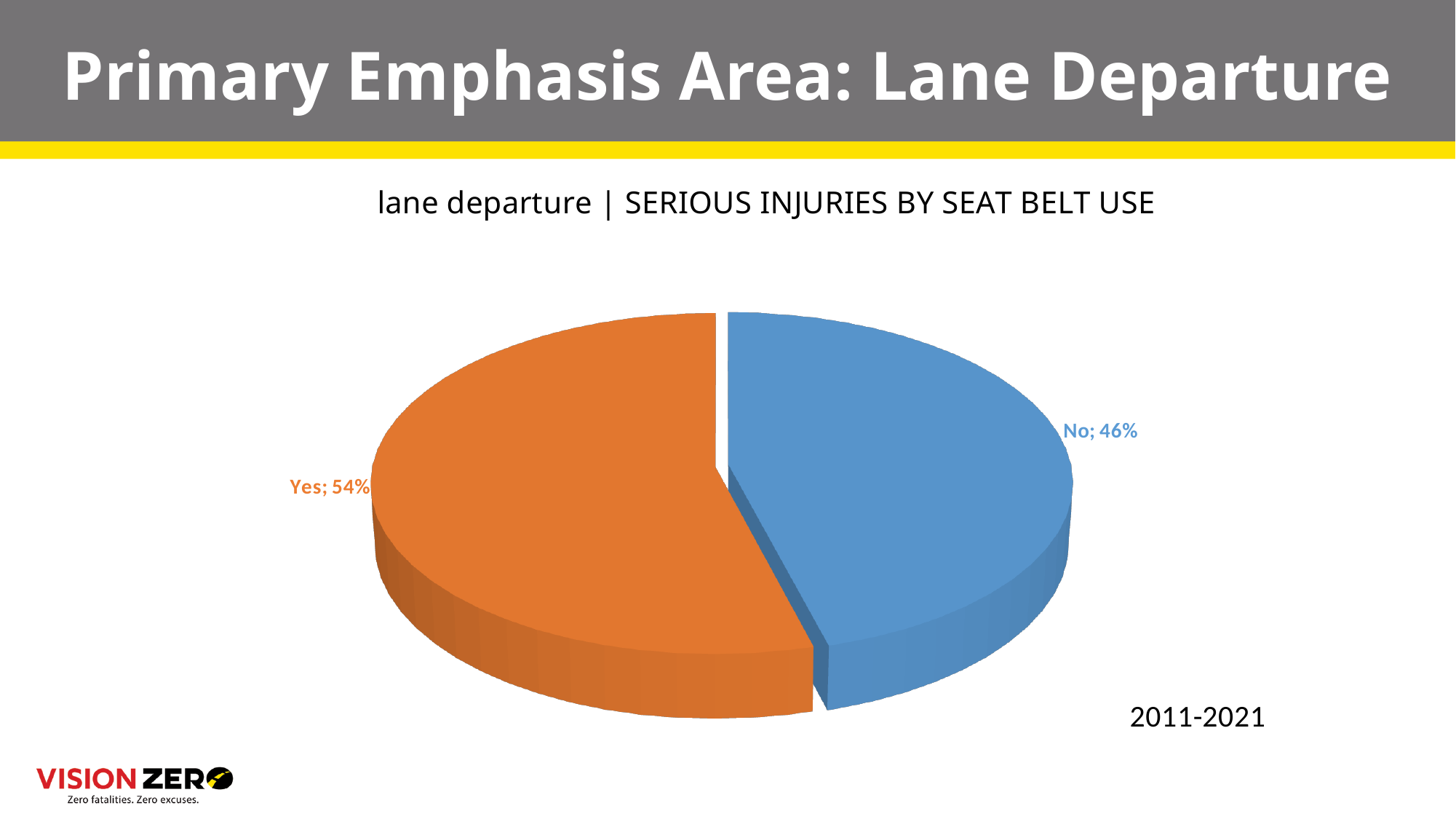
Which slice of the pie chart is the largest? Yes What is the title of the chart? lane departure | SERIOUS INJURIES BY SEAT BELT USE What colour is the Yes slice of the pie chart? Orange Which is larger, the Yes slice or the No slice? Yes How many slices does the pie chart have? 2 What share of serious injuries in lane departure crashes involved seat belt use (Yes)? 54% Which slice of the pie chart is the smallest? No What kind of chart is shown on the slide? Pie chart What time period does the chart cover? 2011-2021 What is the difference in percentage points between the Yes and No slices? 8 What share of serious injuries in lane departure crashes did not involve seat belt use (No)? 46%